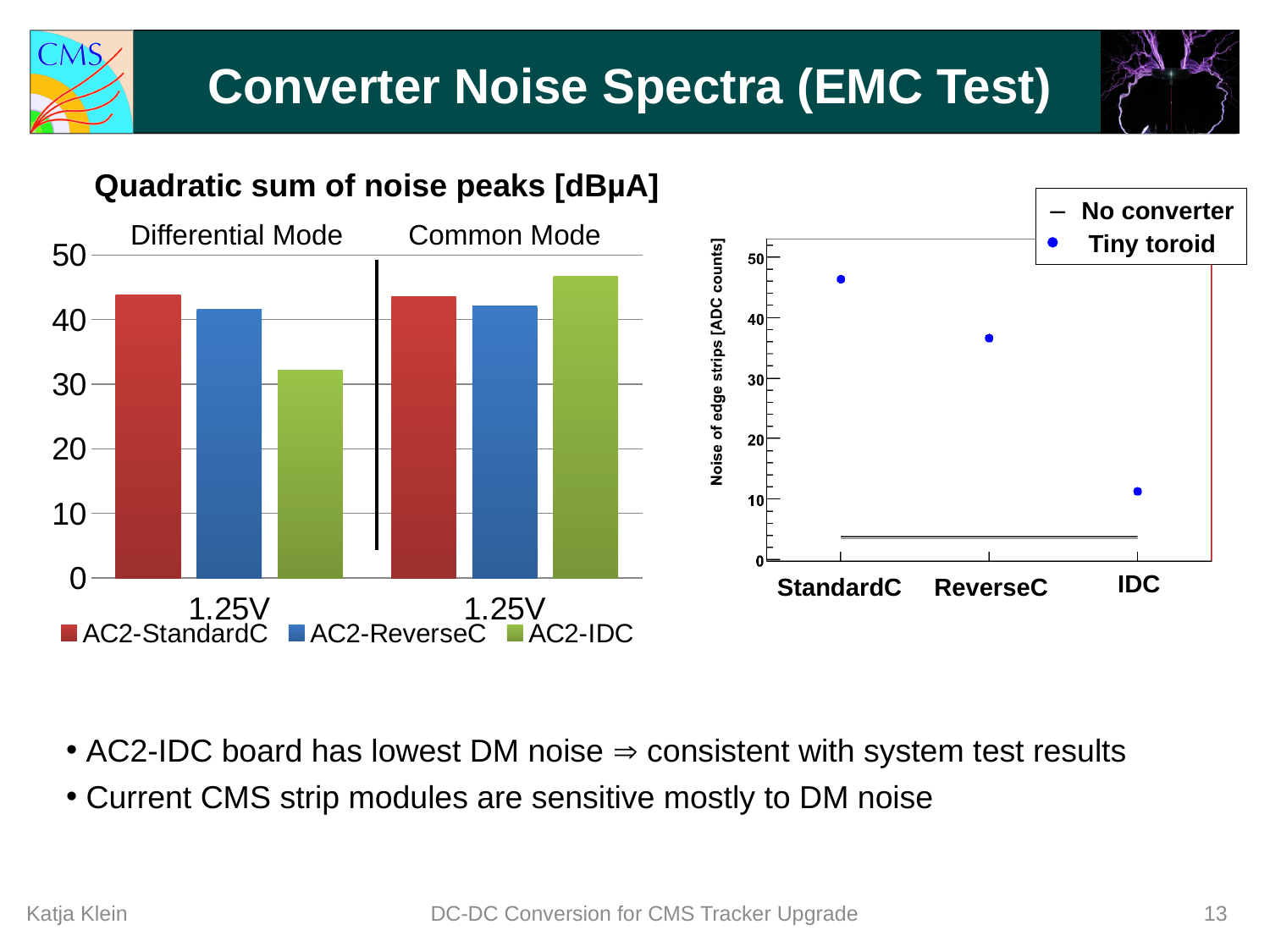
In the left bar chart, which is larger in Differential Mode: AC2-StandardC or AC2-IDC? AC2-StandardC In the right chart of noise of edge strips, which category has the lowest Tiny toroid value? IDC How many categories are shown on the x axis of the right chart of noise of edge strips? 3 In the right chart of noise of edge strips, is the Tiny toroid value for StandardC greater or less than 40? greater What kind of chart is the left chart titled 'Quadratic sum of noise peaks [dBµA]'? bar chart How many series does the legend of the left bar chart list? 3 What are the two legend entries of the right chart of noise of edge strips? No converter, Tiny toroid In the right chart of noise of edge strips, is the Tiny toroid value for IDC greater or less than 20? less In the left bar chart, is the Common Mode value for AC2-IDC greater or less than 40? greater In the left bar chart, which series has the lowest value in Differential Mode? AC2-IDC In the left bar chart, which series has the highest value in Common Mode? AC2-IDC